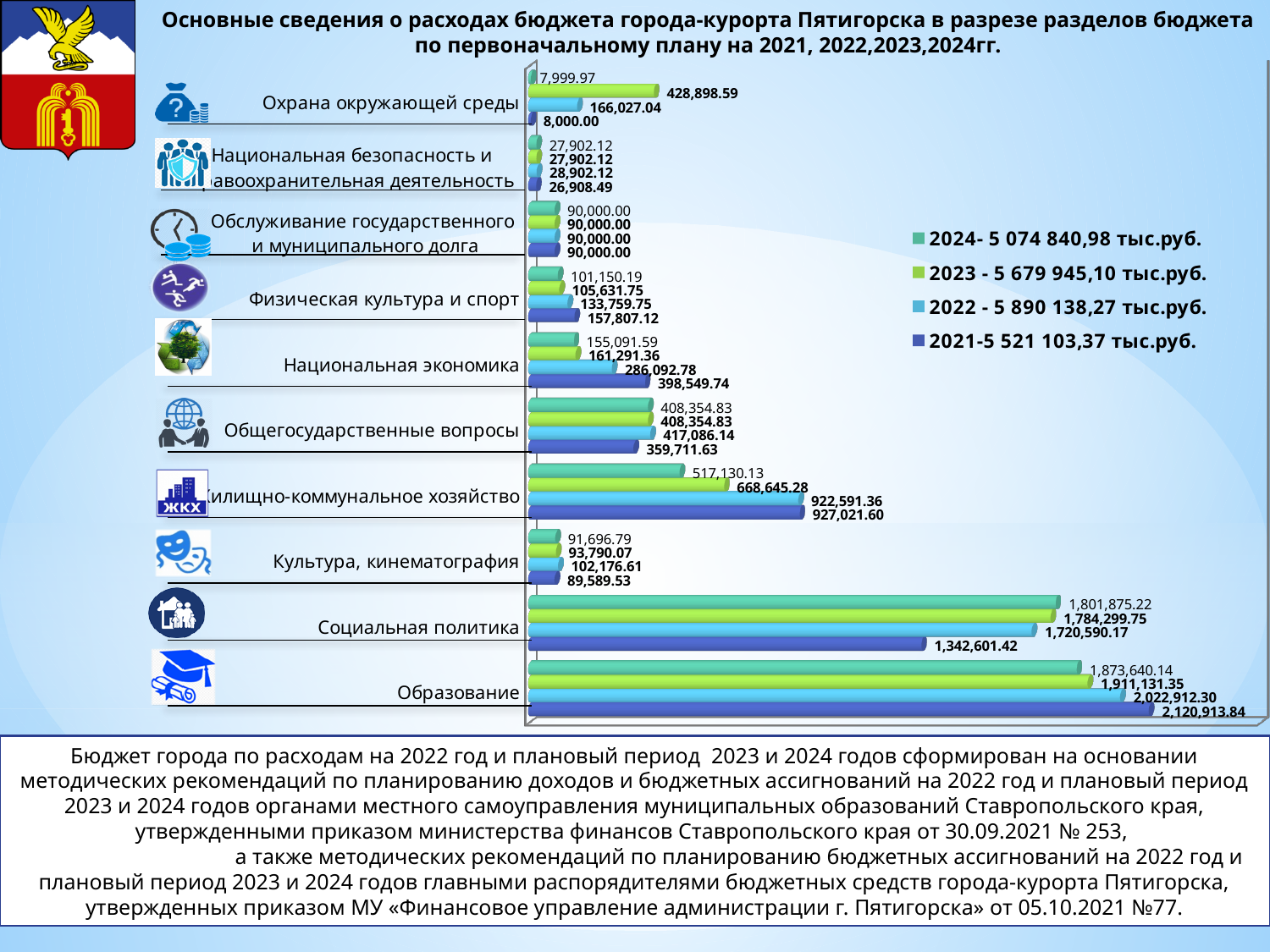
What is the 2021 value for Образование? 2,120,913.84 What is the 2023 value for Охрана окружающей среды? 428,898.59 Which category has the lowest 2024 value? Охрана окружающей среды What is the difference between the 2021 and 2024 values for Социальная политика? 459,273.80 What kind of chart is shown on the slide? bar chart How many budget sections (categories) are shown in the chart? 10 Which is larger for Национальная экономика: the 2021 value or the 2022 value? 2021 Which category has the highest 2021 value? Образование What is the 2022 value for Жилищно-коммунальное хозяйство? 922,591.36 What is the 2024 value for Обслуживание государственного и муниципального долга? 90,000.00 According to the legend, what is the total budget for 2022? 5 890 138,27 тыс.руб. How many series does the legend list? 4